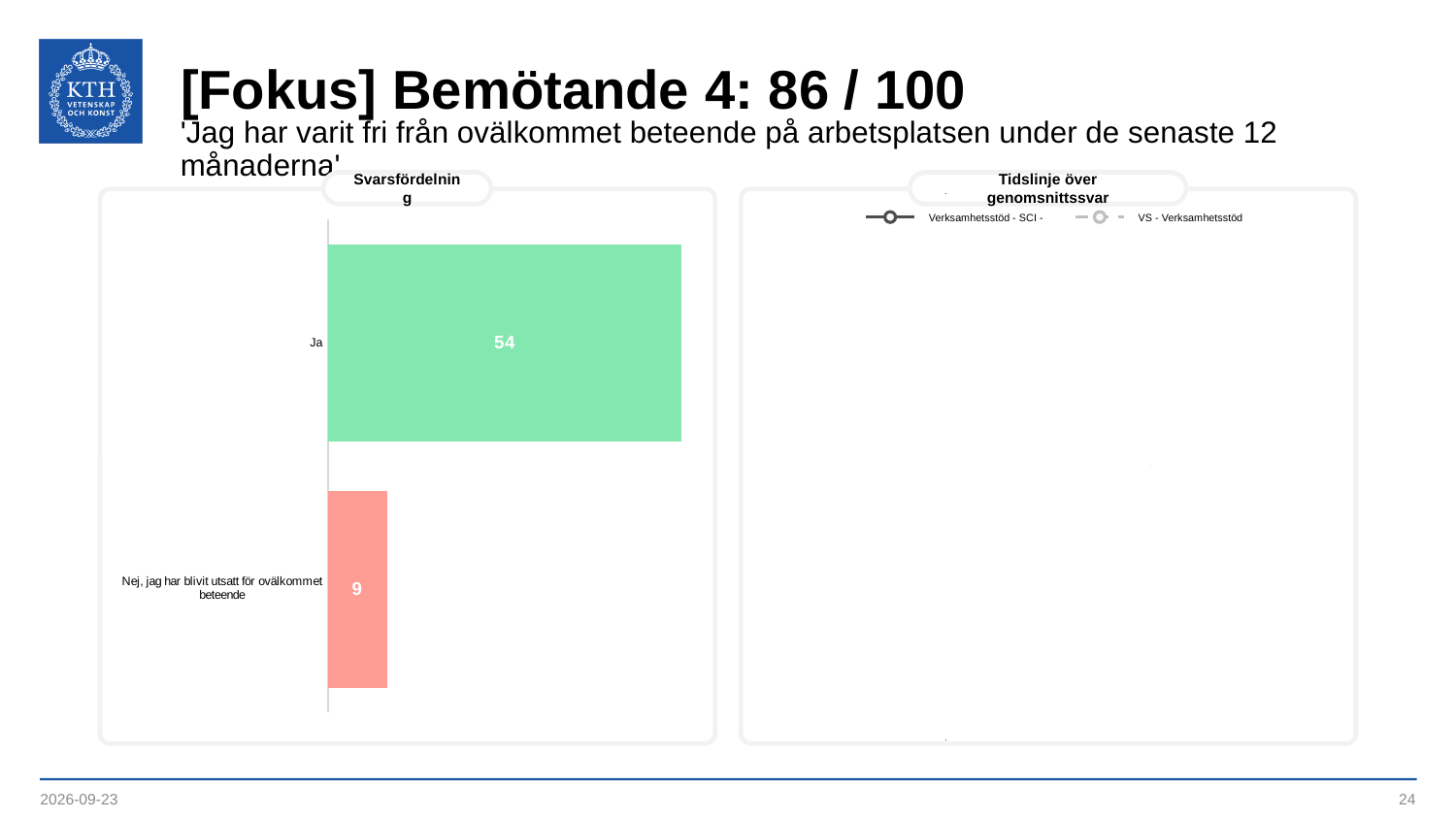
In the Svarsfördelning chart, what is the difference between the value for 'Ja' and the value for 'Nej, jag har blivit utsatt för ovälkommet beteende'? 45 What colour is the bar for 'Ja' in the Svarsfördelning chart? Green In the Svarsfördelning chart, what is the value for 'Nej, jag har blivit utsatt för ovälkommet beteende'? 9 How many series does the legend of the 'Tidslinje över genomsnittssvar' chart list? 2 In the Svarsfördelning chart, which category has the highest value? Ja In the Svarsfördelning chart, which is larger: the value for 'Ja' or the value for 'Nej, jag har blivit utsatt för ovälkommet beteende'? Ja What kind of chart is the Svarsfördelning chart? Bar chart What is the title of the chart on the right side of the slide? Tidslinje över genomsnittssvar In the Svarsfördelning chart, which category has the lowest value? Nej, jag har blivit utsatt för ovälkommet beteende In the Svarsfördelning chart, what is the value for 'Ja'? 54 How many categories are shown in the Svarsfördelning chart? 2